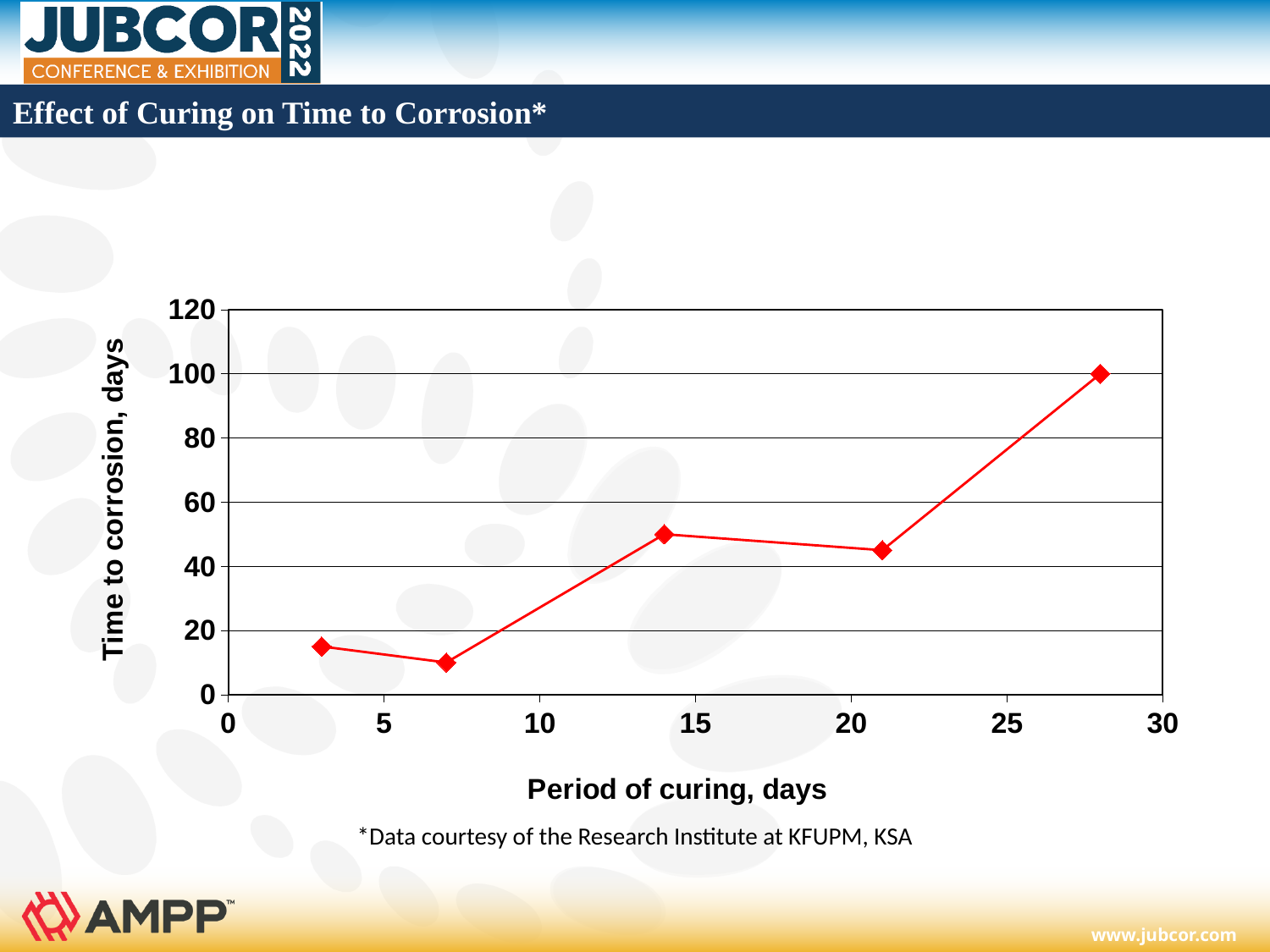
Is the time to corrosion for the point plotted at about 21 days of curing greater or less than 60? less How many data points are plotted on the chart? 5 What is the title of the y axis? Time to corrosion, days Is the time to corrosion for the point plotted at about 3 days of curing greater or less than 20? less What is the title of the x axis? Period of curing, days What kind of chart is shown on the slide? line chart What is the time to corrosion for the point plotted at 28 days of curing? 100 Overall, does the time to corrosion rise or fall as the period of curing increases? rise Which has a larger time to corrosion: the point at 28 days of curing or the point at about 14 days of curing? 28 days Is the time to corrosion for the point plotted at about 7 days of curing greater or less than 20? less At which period of curing is the time to corrosion highest? 28 days